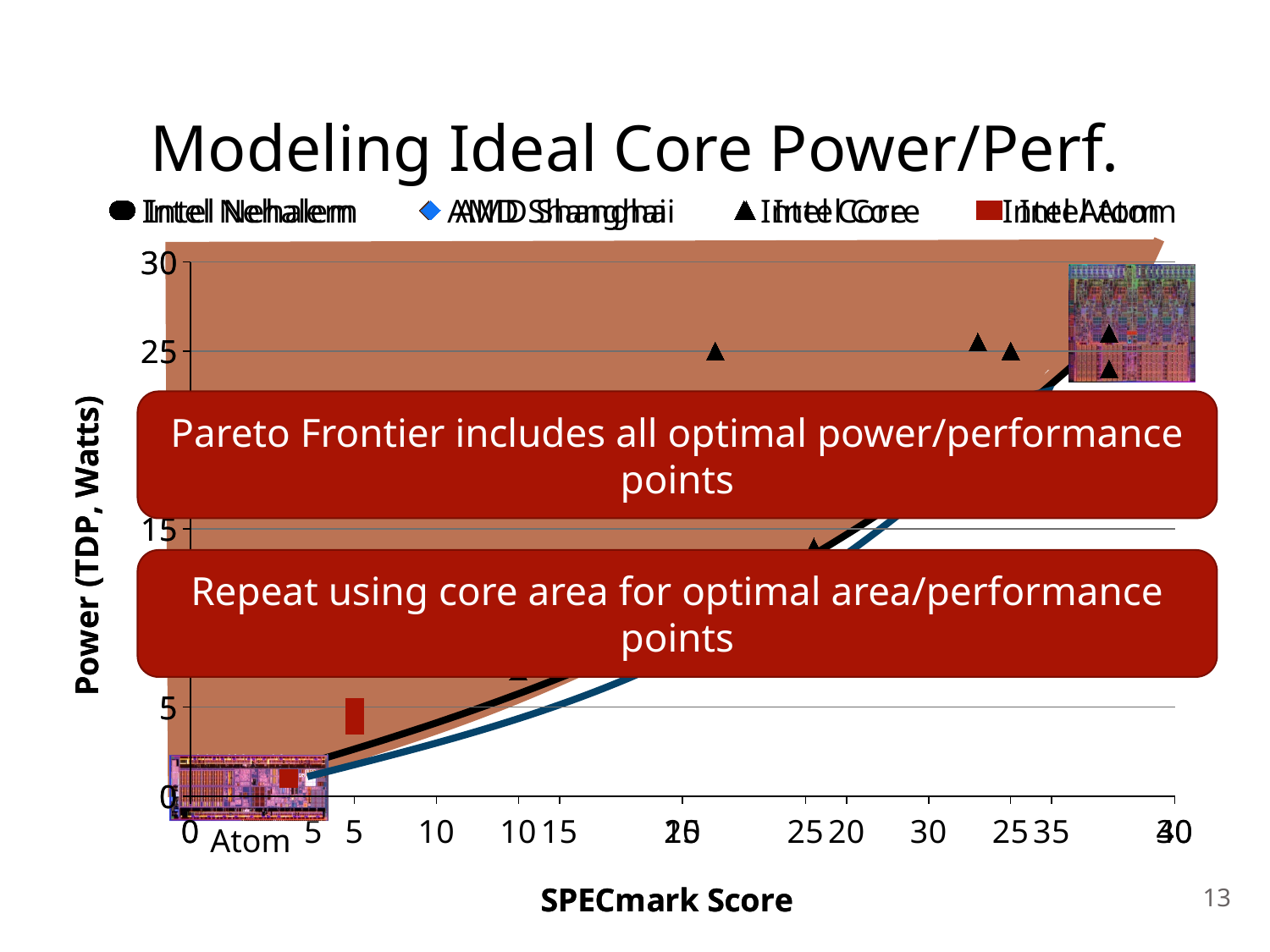
What is the title of the chart on the slide? Modeling Ideal Core Power/Perf. What is the label of the vertical axis of the chart? Power (TDP, Watts) What kind of chart is shown on the slide? scatter chart How many series does the chart's legend list? 4 Is the power value of the Intel Core point plotted near a SPECmark score of 21 greater or less than 30? less Is the power value of the Intel Core point plotted near a SPECmark score of 21 greater or less than 20? greater Is the power value of the Intel Atom point plotted near a SPECmark score of 5 greater or less than 10? less Which series has higher power values on the chart, Intel Core or Intel Atom? Intel Core